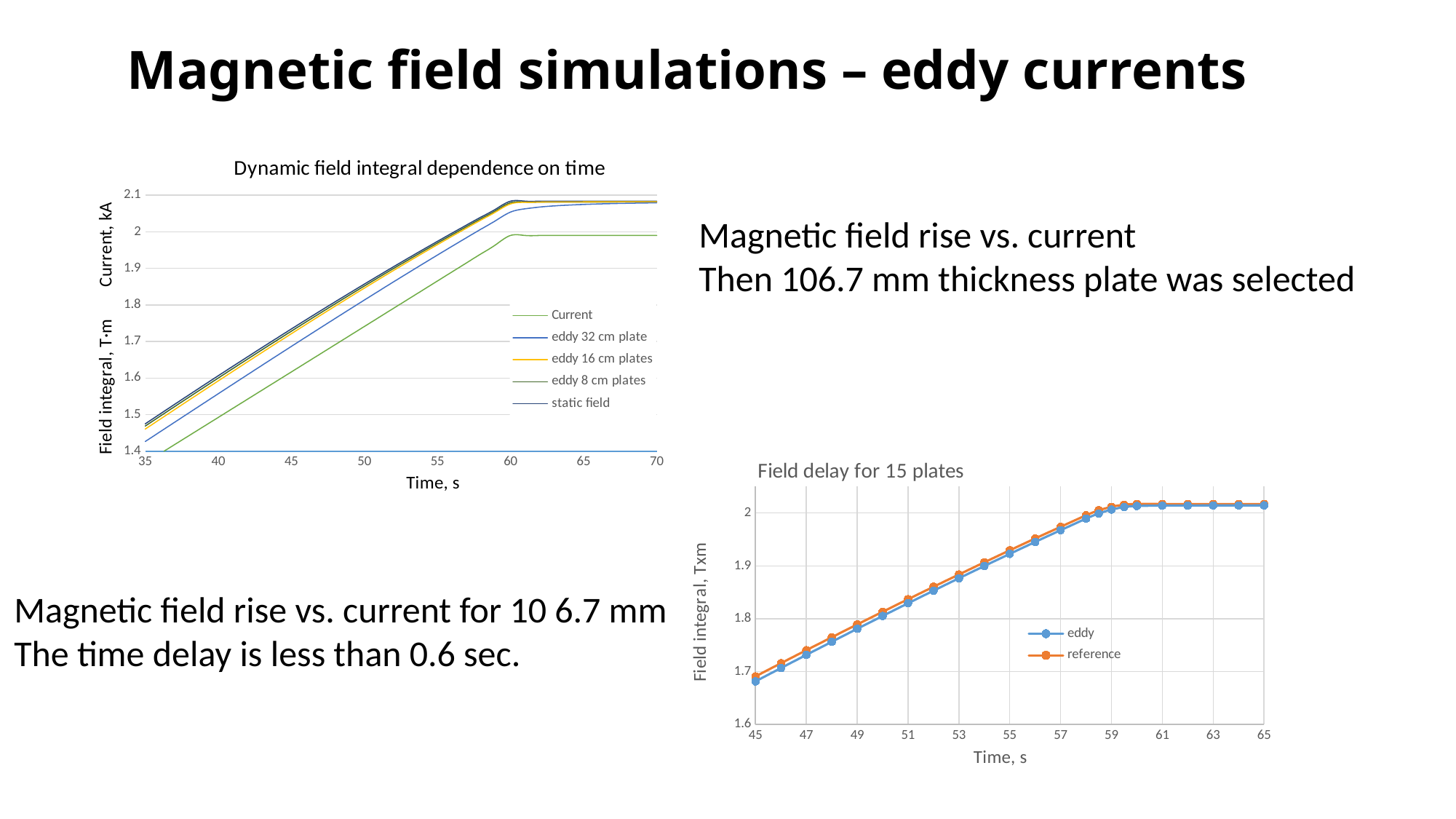
How many series does the legend of the 'Dynamic field integral dependence on time' chart list? 5 How many series does the legend of the 'Field delay for 15 plates' chart list? 2 What type of chart is the 'Dynamic field integral dependence on time' chart? line chart In the 'Field delay for 15 plates' chart, how do the values change as time increases from 45 s to 59 s? They rise In the 'Dynamic field integral dependence on time' chart, is the value of 'static field' at time 65 s greater or less than 2? greater What type of chart is the 'Field delay for 15 plates' chart? line chart What is the x-axis label of the 'Dynamic field integral dependence on time' chart? Time, s In the 'Field delay for 15 plates' chart, which series has the higher value at time 45 s, 'eddy' or 'reference'? reference In the 'Field delay for 15 plates' chart, is the value of 'eddy' at time 45 s greater or less than 1.7? less In the 'Field delay for 15 plates' chart, is the value of 'reference' at time 61 s greater or less than 2? greater